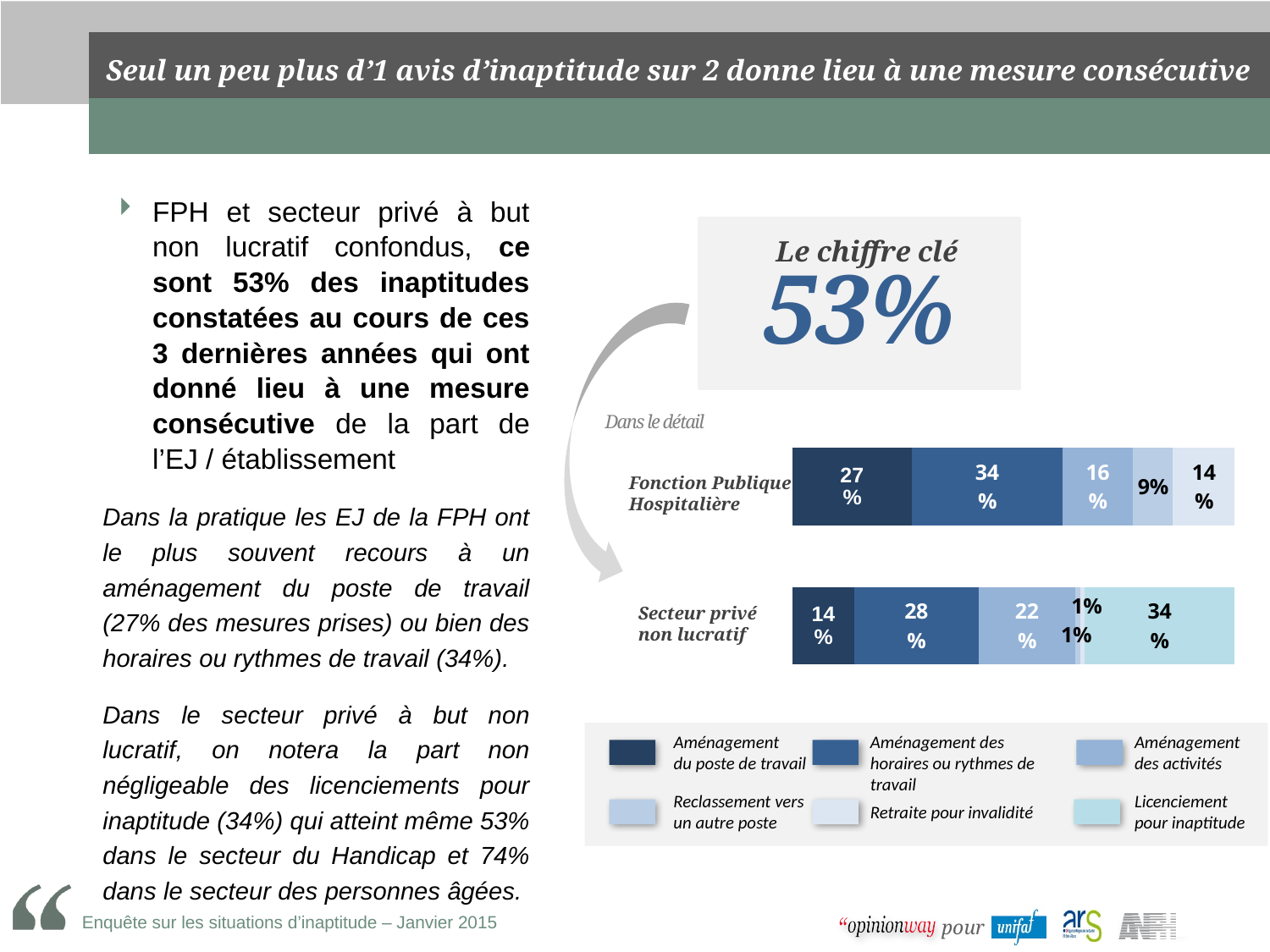
Which segment is the largest in the Fonction Publique Hospitalière bar? Aménagement des horaires ou rythmes de travail What is the value for "Reclassement vers un autre poste" in the Fonction Publique Hospitalière bar? 9% What is the value for "Aménagement du poste de travail" in the Fonction Publique Hospitalière bar? 27% What is the value for "Aménagement des horaires ou rythmes de travail" in the Secteur privé non lucratif bar? 28% What kind of chart is shown under "Dans le détail"? stacked bar chart Which bar has the larger value for "Aménagement du poste de travail", Fonction Publique Hospitalière or Secteur privé non lucratif? Fonction Publique Hospitalière What is the key figure ("Le chiffre clé") displayed above the chart? 53% Which segment is the largest in the Secteur privé non lucratif bar? Licenciement pour inaptitude How many series does the legend list? 6 How many categories (bars) does the chart show? 2 What is the value for "Licenciement pour inaptitude" in the Secteur privé non lucratif bar? 34%